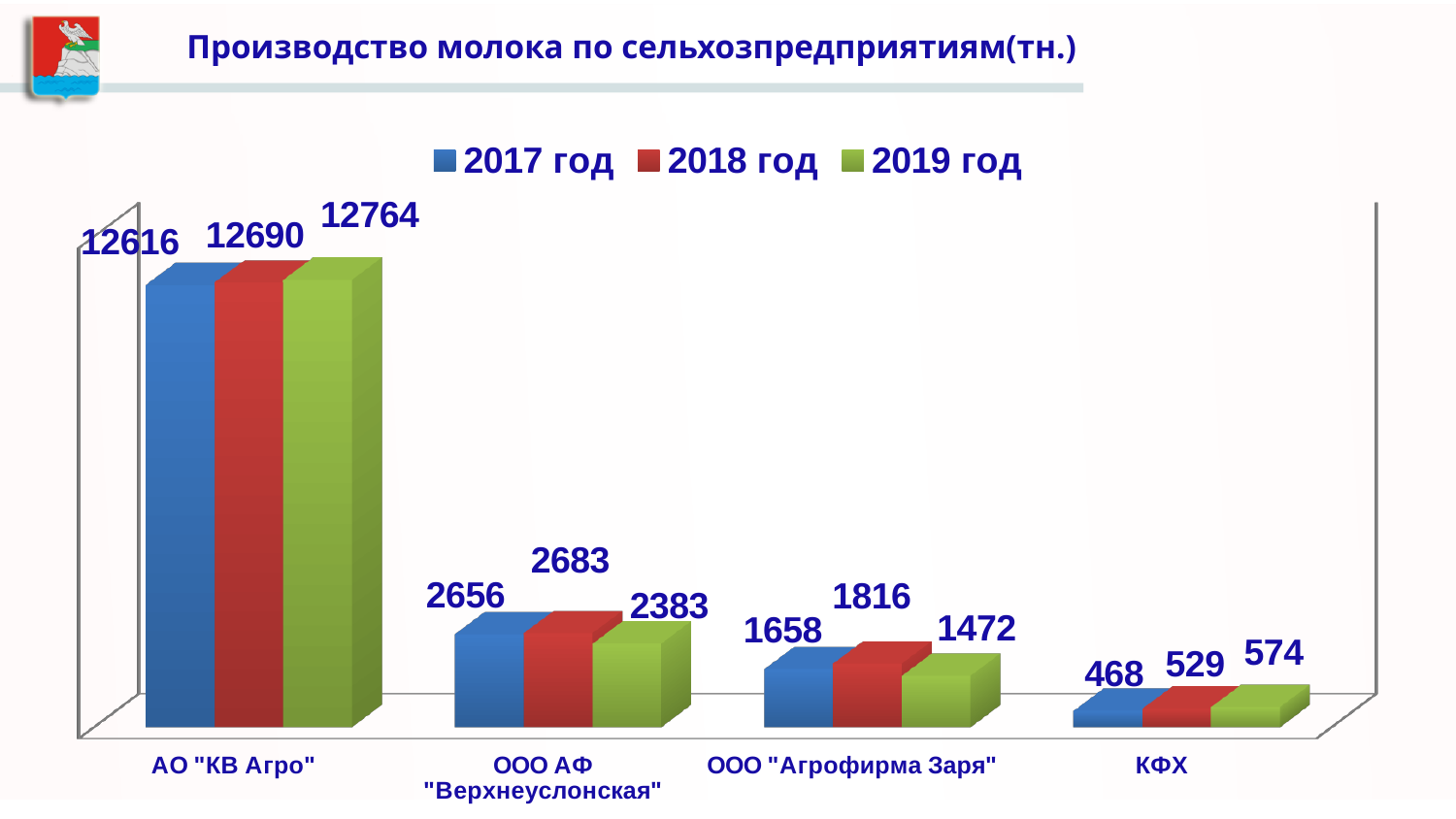
Which category has the lowest 2019 год value? КФХ What is the 2018 год value for КФХ? 529 Which is larger for ООО "Агрофирма Заря": the 2017 год value or the 2019 год value? 2017 год How many categories are shown on the x axis? 4 Which category has the highest 2018 год value? АО "КВ Агро" What is the 2019 год value for АО "КВ Агро"? 12764 How many series does the legend list? 3 What is the difference between the 2019 год and 2017 год values for АО "КВ Агро"? 148 What is the 2017 год value for ООО "Агрофирма Заря"? 1658 What kind of chart is shown on the slide? bar chart Do the values for КФХ rise or fall from 2017 год to 2019 год? rise What is the difference between the 2018 год and 2019 год values for ООО АФ "Верхнеуслонская"? 300